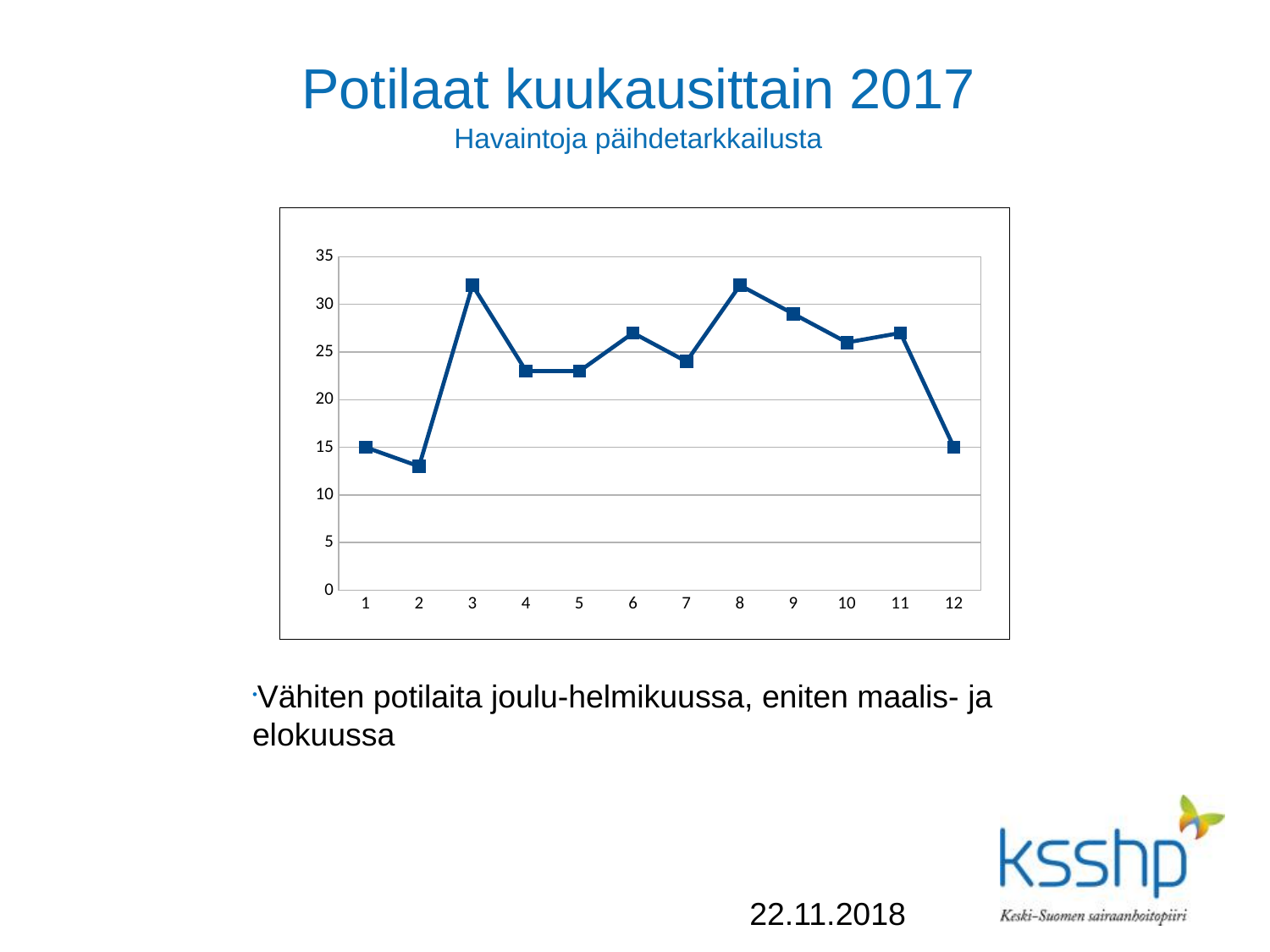
Which has a higher value, month 3 or month 4? month 3 Which has a higher value, month 9 or month 10? month 9 Do the values rise or fall from month 8 to month 12? fall What is the title of the slide containing the chart? Potilaat kuukausittain 2017 Which month has the lowest number of patients? 2 Is the value for month 2 greater or less than 15? less Is the value for month 3 greater or less than 30? greater What kind of chart is shown on the slide? line chart Is the value for month 6 greater or less than 25? greater How many months (points) are plotted on the x axis? 12